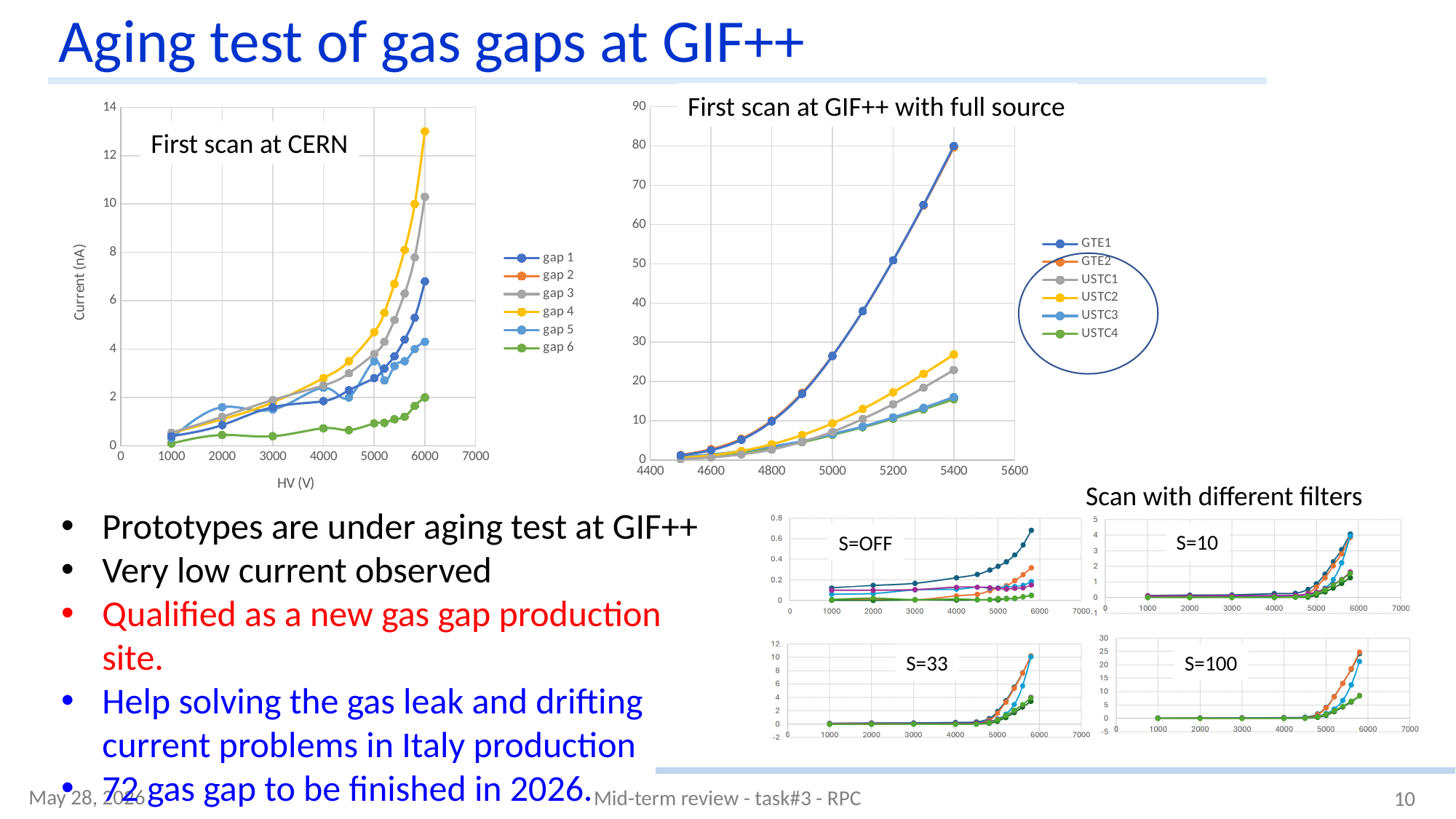
In the 'First scan at CERN' chart, how many series does the legend list? 6 In the 'First scan at CERN' chart, what is the label of the y axis? Current (nA) In the 'First scan at CERN' chart, is the value for gap 4 at 6000 V greater or less than 12? greater In the 'First scan at GIF++ with full source' chart, is the value for USTC4 at 5400 greater or less than 20? less In the 'First scan at CERN' chart, is the value for gap 6 at 6000 V greater or less than 4? less In the 'First scan at GIF++ with full source' chart, how many series does the legend list? 6 In the 'First scan at CERN' chart, which series has the lowest current at 6000 V? gap 6 In the 'First scan at GIF++ with full source' chart, does the GTE1 series rise or fall as the x-axis value increases? rise What kind of chart is the 'First scan at GIF++ with full source' chart? line chart In the 'First scan at CERN' chart, which series reaches the highest current at 6000 V? gap 4 In the 'First scan at CERN' chart, what is the label of the x axis? HV (V)